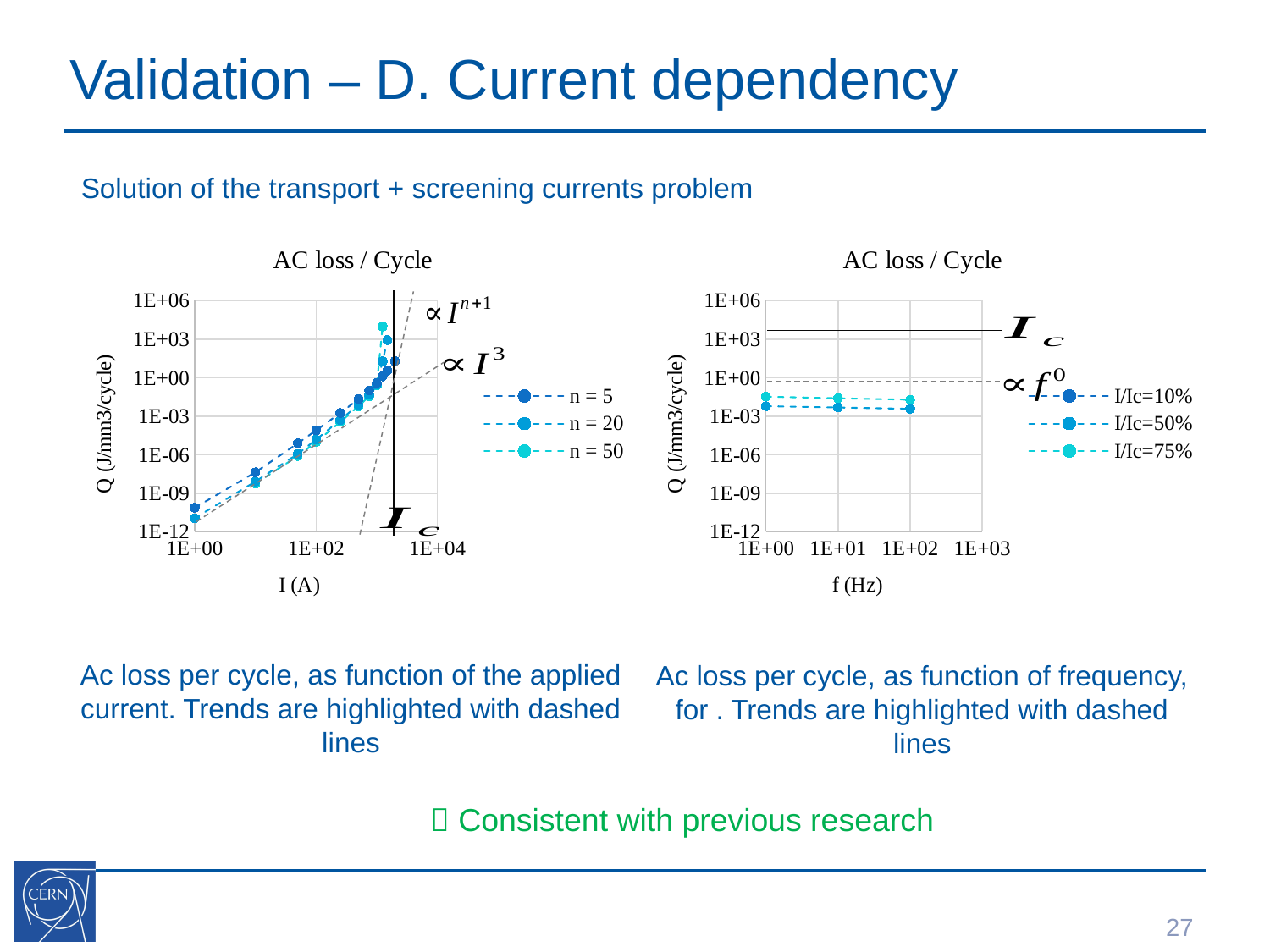
What kind of chart is the left chart? line chart How many series does the legend of the right chart list? 3 In the left chart, is the value for n = 5 at I = 1E+00 A greater or less than 1E-06? less How many series does the legend of the left chart list? 3 What are the series names in the legend of the right chart? I/Ic=10%, I/Ic=50%, I/Ic=75% In the left chart, is the highest plotted value for n = 50 greater or less than 1E+03? greater What is the title of the right chart? AC loss / Cycle In the right chart, is the value for I/Ic=75% at 1E+02 Hz greater or less than 1E-06? greater What are the series names in the legend of the left chart? n = 5, n = 20, n = 50 In the right chart, do the AC loss values rise, fall, or stay roughly constant as frequency increases? stay roughly constant In the left chart, do the AC loss values rise or fall as the current I increases? rise